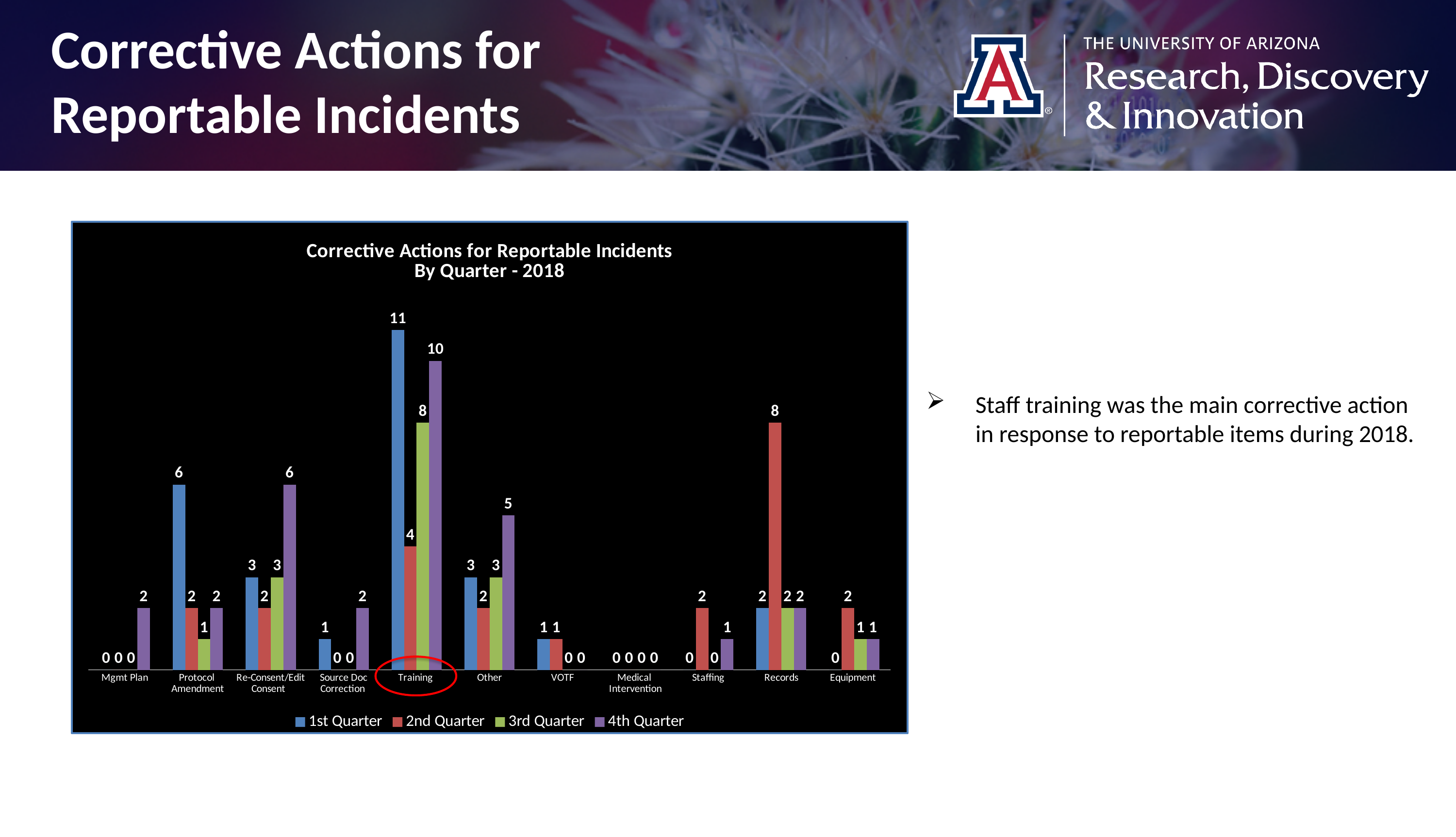
What is the difference between the 1st Quarter and 2nd Quarter values for Training? 7 Which category is circled in red on the chart? Training What is the 1st Quarter value for Training? 11 Which category has the highest 2nd Quarter value? Records What kind of chart is shown? Bar chart Which category has the highest 4th Quarter value? Training How many series does the legend list? 4 What is the 2nd Quarter value for Records? 8 What is the 3rd Quarter value for Protocol Amendment? 1 Which is larger: the 4th Quarter value for Other or the 4th Quarter value for Protocol Amendment? Other How many categories are shown on the x axis? 11 What is the 4th Quarter value for Re-Consent/Edit Consent? 6